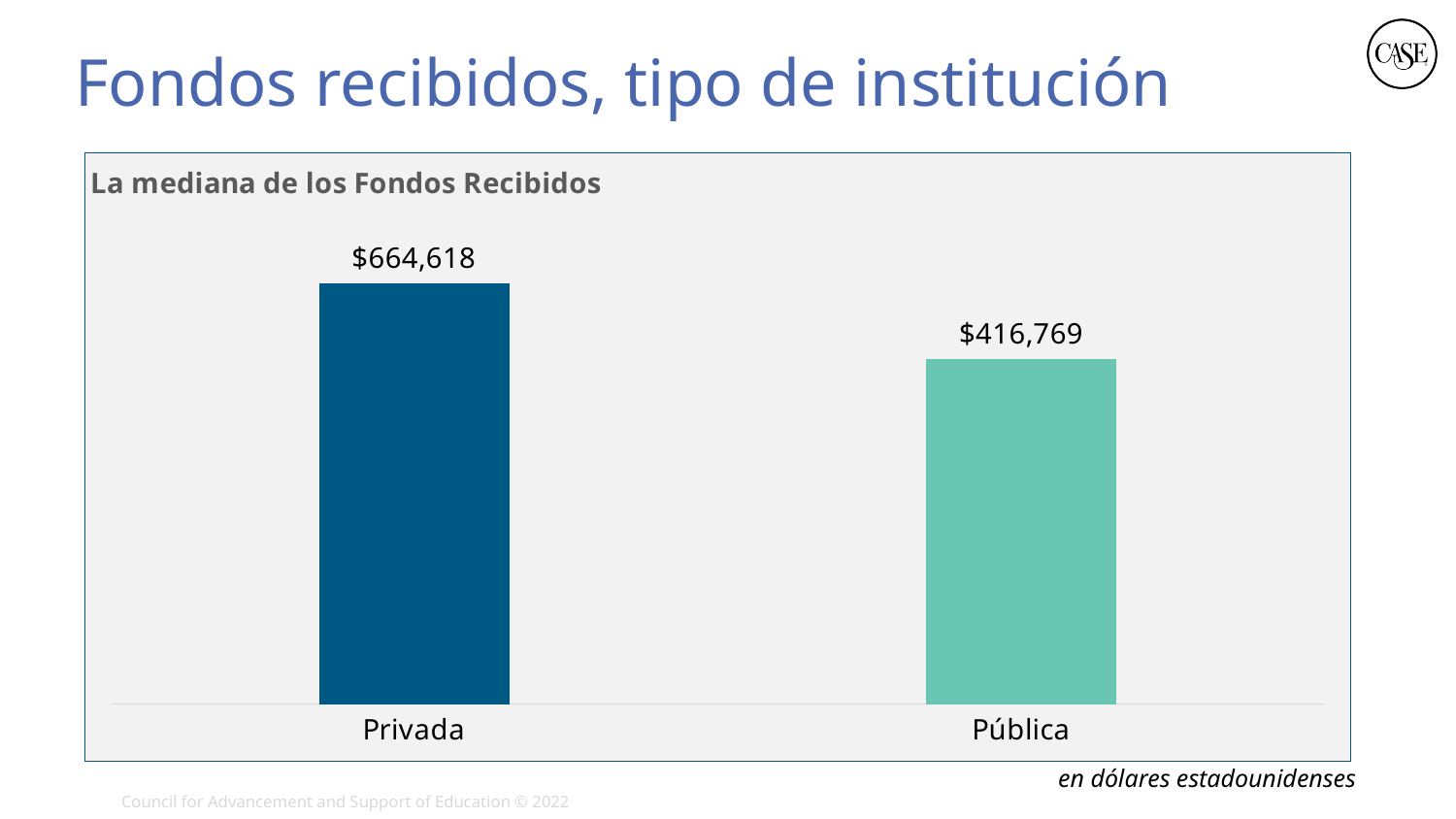
How many categories are shown in the chart? 2 Which institution type has the higher median funds received? Privada What is the title of the chart? La mediana de los Fondos Recibidos Is the value for Privada larger or smaller than the value for Pública? larger Which institution type has the lower median funds received? Pública What is the median funds received for Privada? $664,618 What kind of chart is shown on the slide? bar chart In what currency are the chart values expressed, according to the note below the chart? en dólares estadounidenses What is the median funds received for Pública? $416,769 What is the difference between the median funds received for Privada and Pública? $247,849